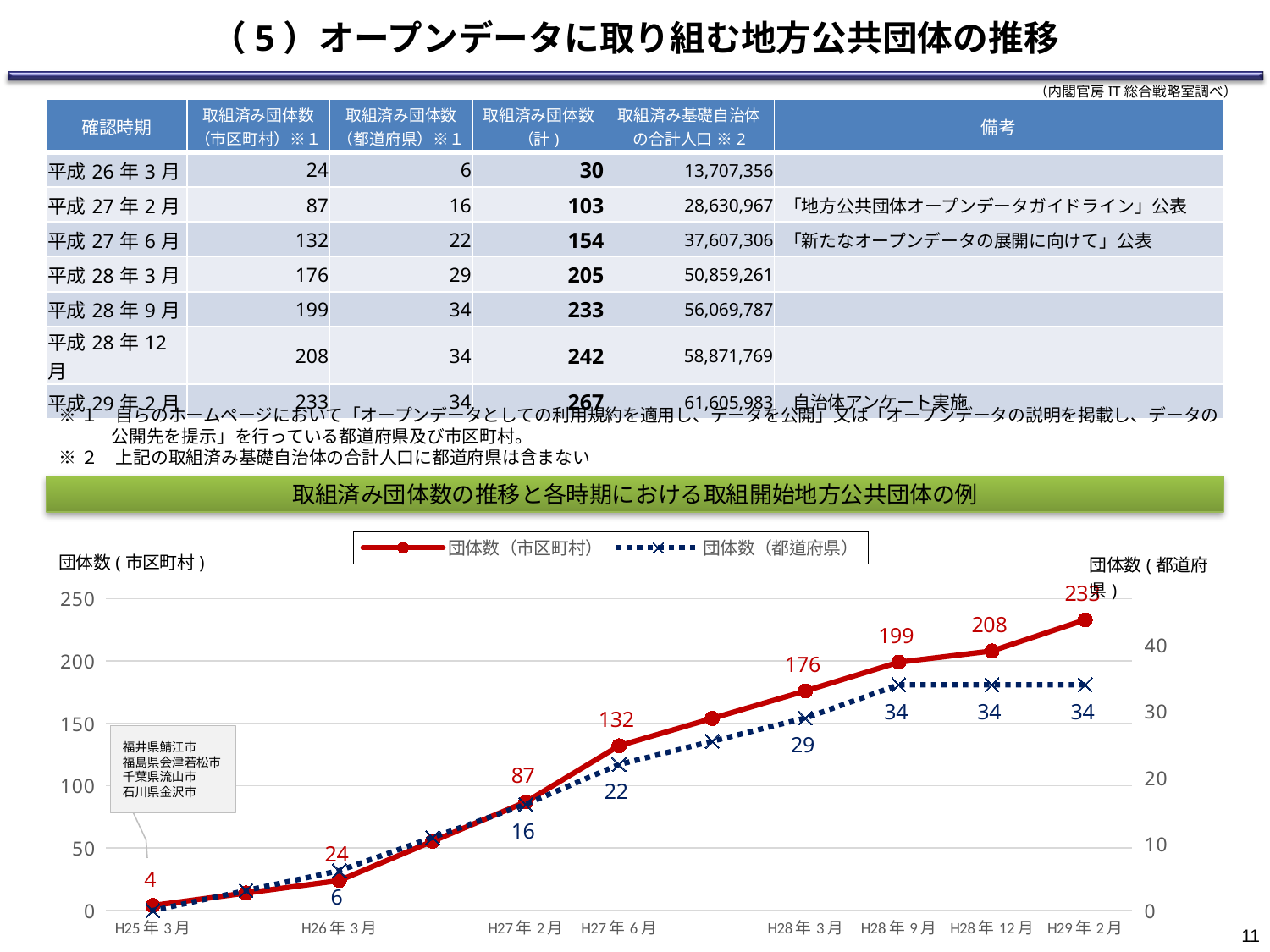
In the line chart, what is the difference between 団体数（都道府県） at H27年6月 and at H27年2月? 6 In the line chart, what is the value of 団体数（市区町村） at H26年3月? 24 What kind of chart is shown at the bottom of the slide? Line chart In the line chart, what is the value of 団体数（都道府県） at H28年3月? 29 In the line chart, at which period is 団体数（市区町村） lowest? H25年3月 In the line chart, is 団体数（市区町村） larger at H27年6月 or at H28年3月? H28年3月 In the line chart, what is the difference between 団体数（市区町村） at H28年12月 and at H28年9月? 9 In the line chart, at which period is 団体数（市区町村） highest? H29年2月 How many series does the legend of the line chart list? 2 In the line chart, what is the value of 団体数（市区町村） at H27年2月? 87 In the line chart, what is the value of 団体数（市区町村） at H28年9月? 199 In the line chart, what is the value of 団体数（都道府県） at H27年6月? 22